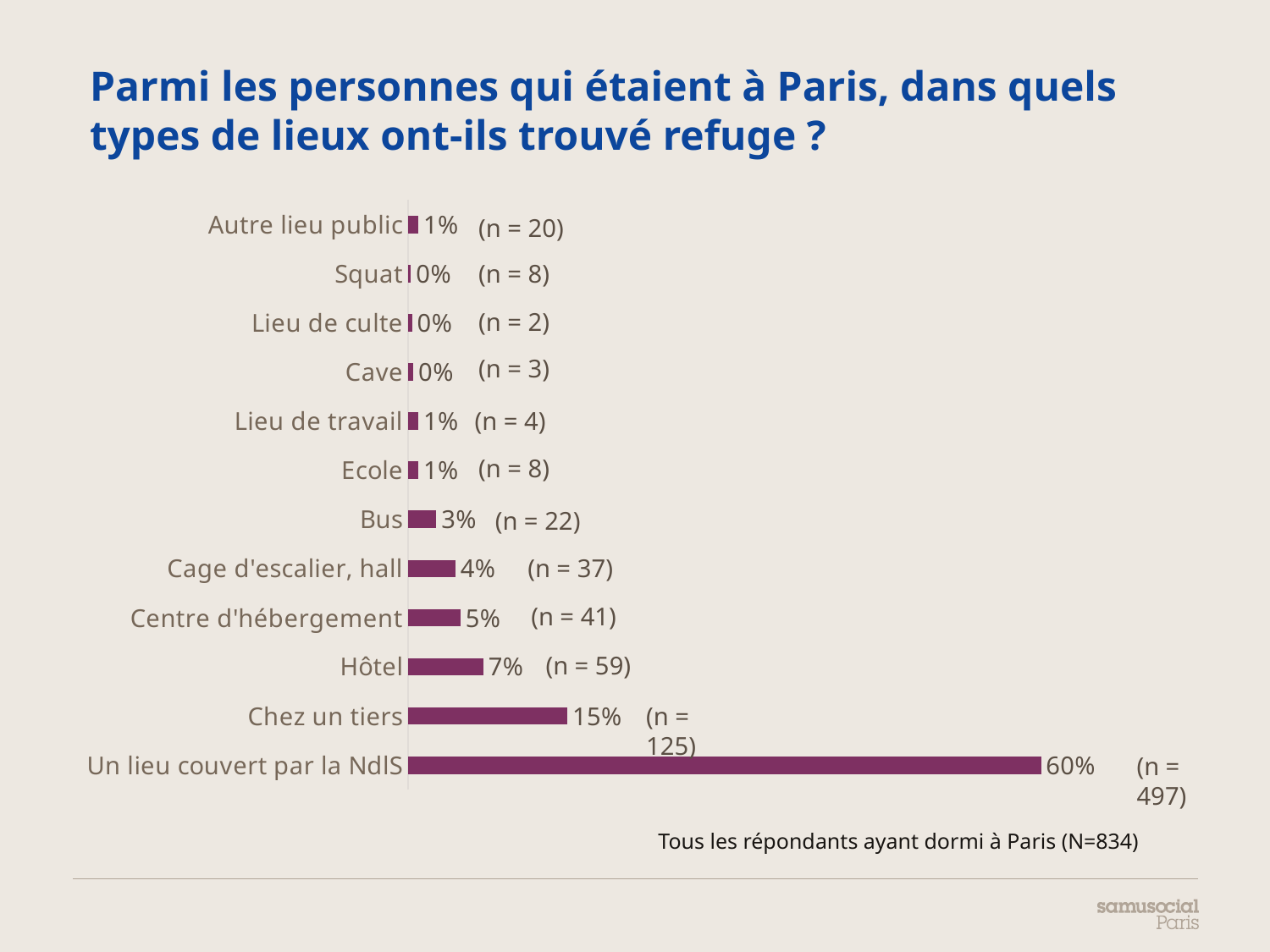
According to the note below the chart, how many respondents slept in Paris (N)? 834 What percentage of respondents found refuge in "Un lieu couvert par la NdlS"? 60% How many categories are shown in the chart? 12 Which has a higher percentage, "Cage d'escalier, hall" or "Hôtel"? Hôtel What type of chart is shown on the slide? Bar chart What percentage is shown for "Chez un tiers"? 15% What is the n value shown next to "Centre d'hébergement"? n = 41 What is the difference in percentage points between "Un lieu couvert par la NdlS" and "Chez un tiers"? 45% What percentage is shown for "Bus"? 3% What is the difference in percentage points between "Hôtel" and "Centre d'hébergement"? 2% Which category has the highest percentage? Un lieu couvert par la NdlS What percentage is shown for "Hôtel"? 7%